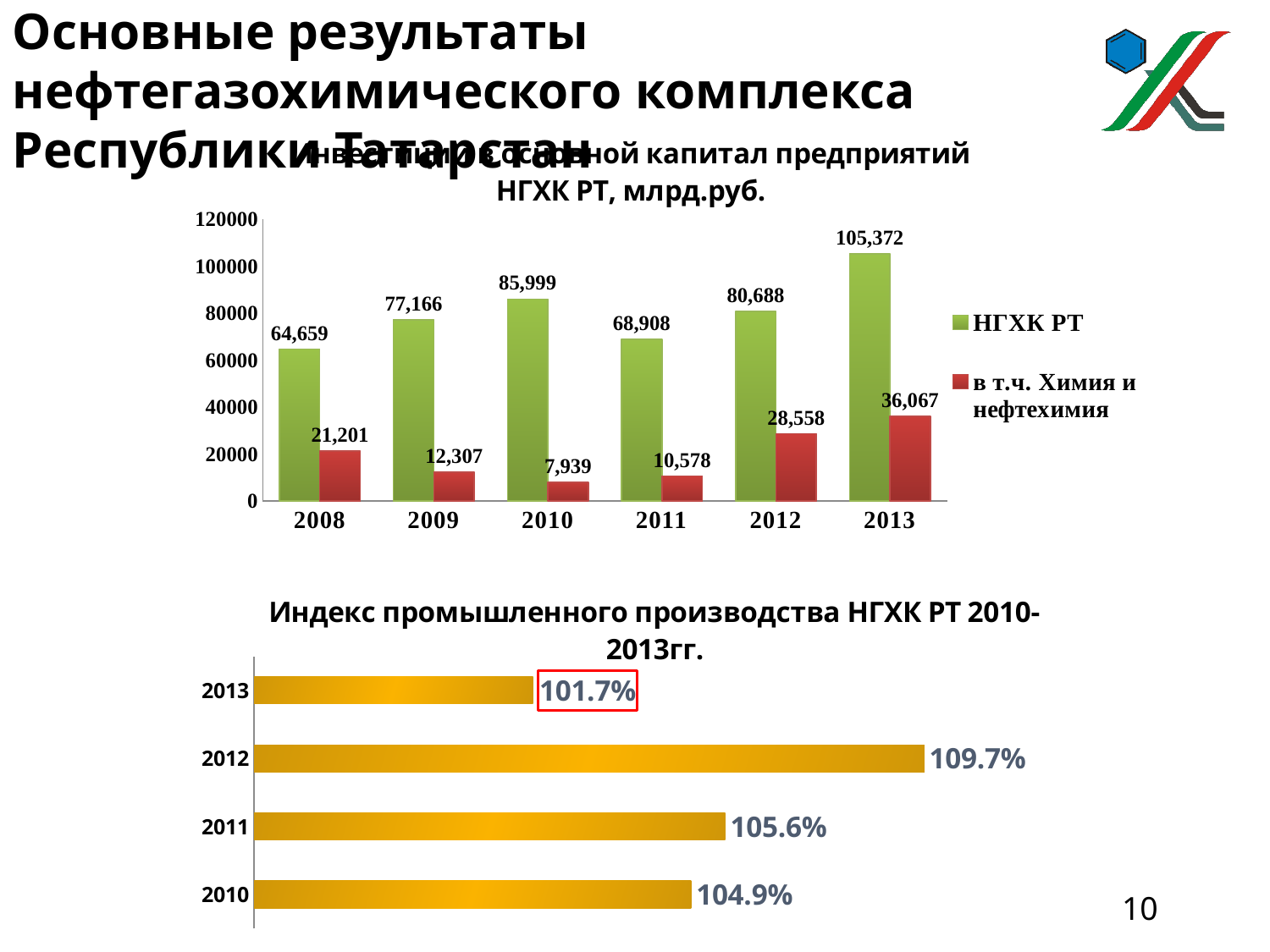
In the top chart on the slide, what is the difference between the НГХК РТ values for 2013 and 2012? 24,684 In the top chart on the slide, which year has the highest value for НГХК РТ? 2013 What kind of chart is the bottom chart on the slide? bar chart In the top chart on the slide, is the НГХК РТ value for 2011 larger or smaller than the value for 2009? smaller In the top chart on the slide, which year has the lowest value for 'в т.ч. Химия и нефтехимия'? 2010 In the top chart on the slide, how many series does the legend list? 2 In the bottom chart on the slide, what is the value for 2012? 109.7% In the bottom chart on the slide, what is the difference between the values for 2012 and 2013? 8.0% In the top chart on the slide, what is the value for НГХК РТ in 2013? 105,372 In the top chart on the slide, what is the value for 'в т.ч. Химия и нефтехимия' in 2010? 7,939 In the bottom chart on the slide, which year has the lowest value? 2013 In the top chart on the slide, how many years are shown on the x axis? 6